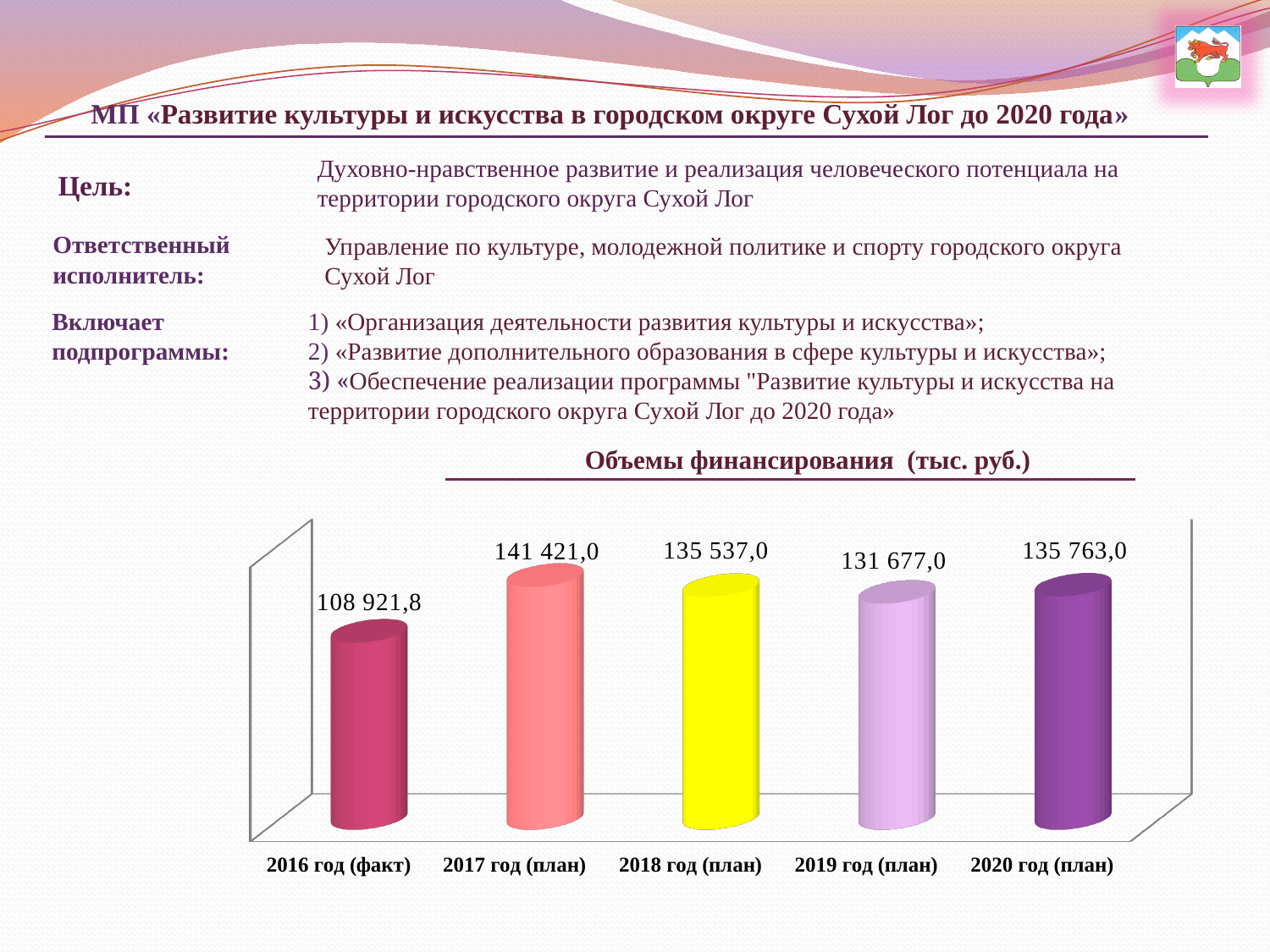
Which year has the lowest value in the chart «Объемы финансирования (тыс. руб.)»? 2016 год (факт) How many bars are shown in the chart «Объемы финансирования (тыс. руб.)»? 5 What is the value for 2020 год (план) in the chart «Объемы финансирования (тыс. руб.)»? 135 763,0 Which is larger in the chart «Объемы финансирования (тыс. руб.)»: the value for 2017 год (план) or for 2019 год (план)? 2017 год (план) What is the value for 2017 год (план) in the chart «Объемы финансирования (тыс. руб.)»? 141 421,0 What kind of chart is «Объемы финансирования (тыс. руб.)»? bar chart What is the difference between the values for 2017 год (план) and 2016 год (факт) in the chart «Объемы финансирования (тыс. руб.)»? 32 499,2 What is the value for 2016 год (факт) in the chart «Объемы финансирования (тыс. руб.)»? 108 921,8 In the chart «Объемы финансирования (тыс. руб.)», does the value rise or fall from 2017 год (план) to 2019 год (план)? fall What is the difference between the values for 2018 год (план) and 2019 год (план) in the chart «Объемы финансирования (тыс. руб.)»? 3 860,0 What is the value for 2019 год (план) in the chart «Объемы финансирования (тыс. руб.)»? 131 677,0 Which year has the highest value in the chart «Объемы финансирования (тыс. руб.)»? 2017 год (план)